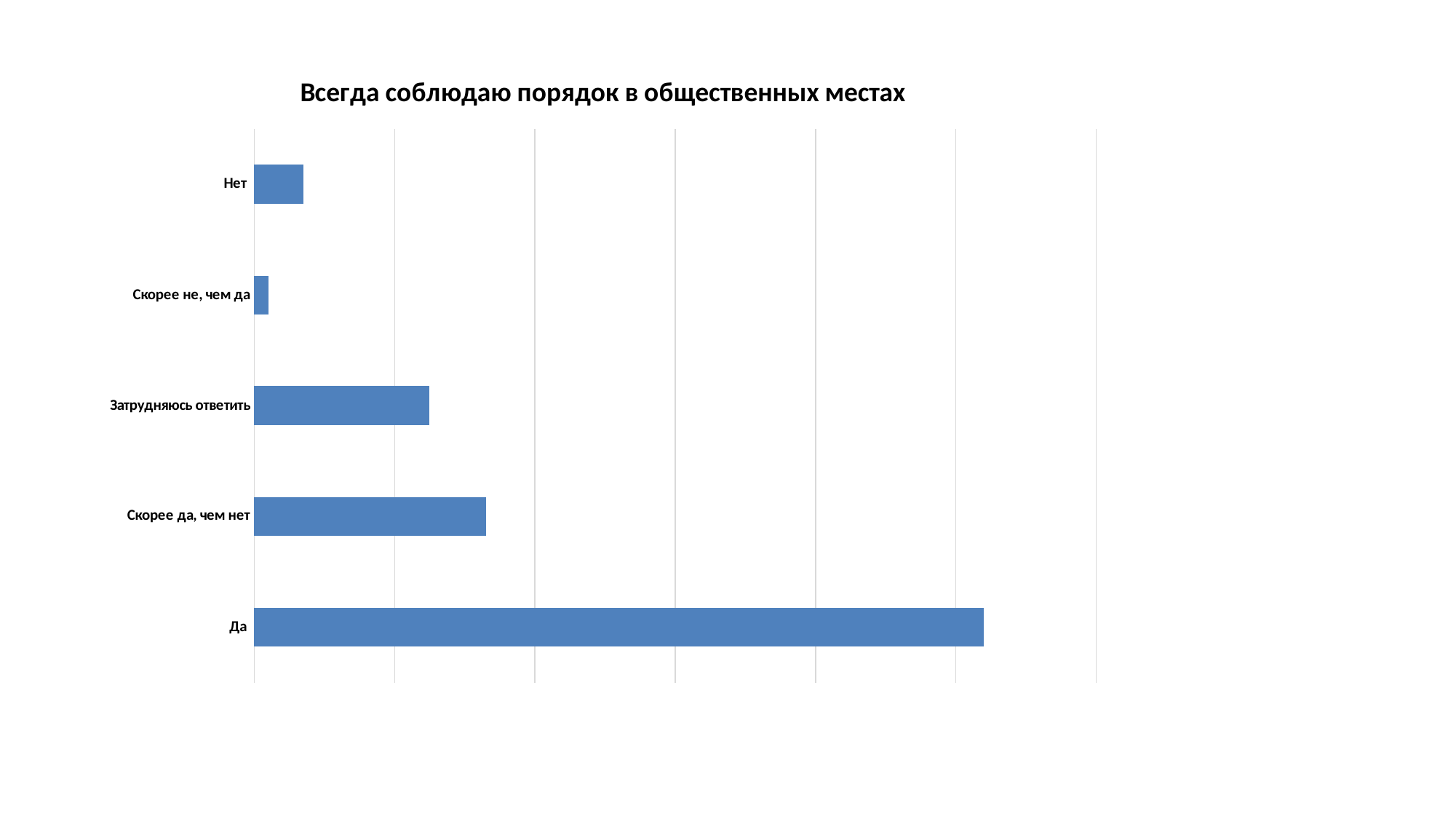
Which is larger, the value for "Нет" or the value for "Скорее не, чем да"? Нет How many categories are shown in the chart? 5 What is the title of the chart? Всегда соблюдаю порядок в общественных местах Which is larger, the value for "Да" or the value for "Скорее да, чем нет"? Да Which category has the lowest value? Скорее не, чем да Which category has the highest value? Да Which is larger, the value for "Скорее да, чем нет" or the value for "Затрудняюсь ответить"? Скорее да, чем нет Are the bars in the chart horizontal or vertical? horizontal Which category is listed at the bottom of the chart? Да What kind of chart is shown on the slide? bar chart